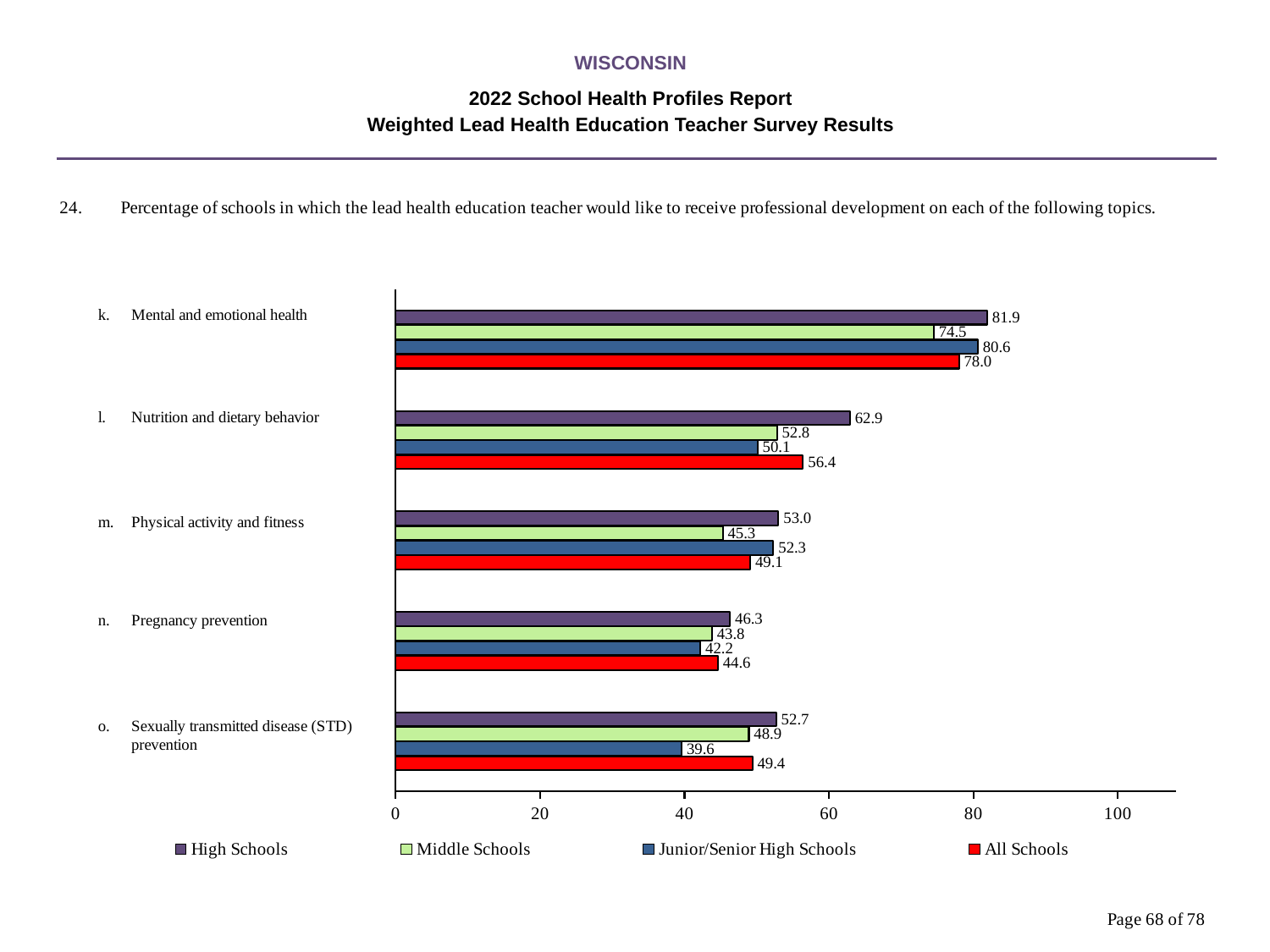
Which topic has the lowest High Schools value? Pregnancy prevention What kind of chart is shown on the slide? Bar chart What is the difference between the High Schools and Middle Schools values for Nutrition and dietary behavior? 10.1 What is the value for High Schools for Mental and emotional health? 81.9 What is the value for Junior/Senior High Schools for Sexually transmitted disease (STD) prevention? 39.6 Which topic has the highest All Schools value? Mental and emotional health Which is larger for Physical activity and fitness: the High Schools value or the Middle Schools value? High Schools How many series does the legend list? 4 What is the All Schools value for Pregnancy prevention? 44.6 What is the value for Middle Schools for Nutrition and dietary behavior? 52.8 How many topics are shown on the chart? 5 Which colour represents All Schools in the legend? Red